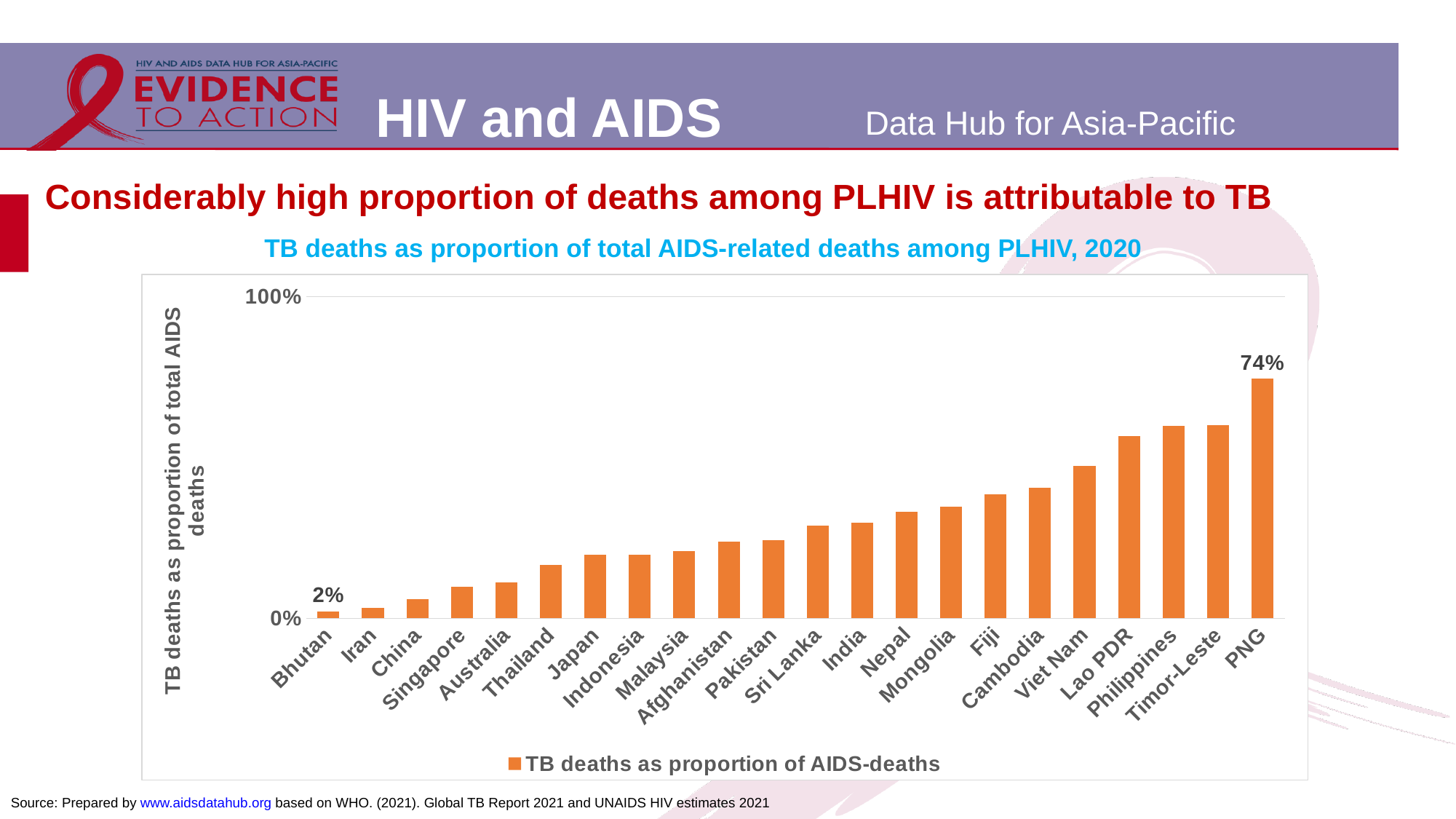
Which has a larger value, Viet Nam or Japan? Viet Nam Which country has the lowest TB deaths as proportion of AIDS-deaths? Bhutan How many countries are shown on the x axis? 22 How many series does the legend list? 1 Do the values rise or fall from left to right along the x axis? Rise Which has a larger value, Thailand or Sri Lanka? Sri Lanka Which country has the highest TB deaths as proportion of AIDS-deaths? PNG What is the difference between the values for PNG and Bhutan? 72% What is the value for PNG? 74% What is the title of the chart? TB deaths as proportion of total AIDS-related deaths among PLHIV, 2020 What type of chart is shown on the slide? Bar chart What is the value for Bhutan? 2%